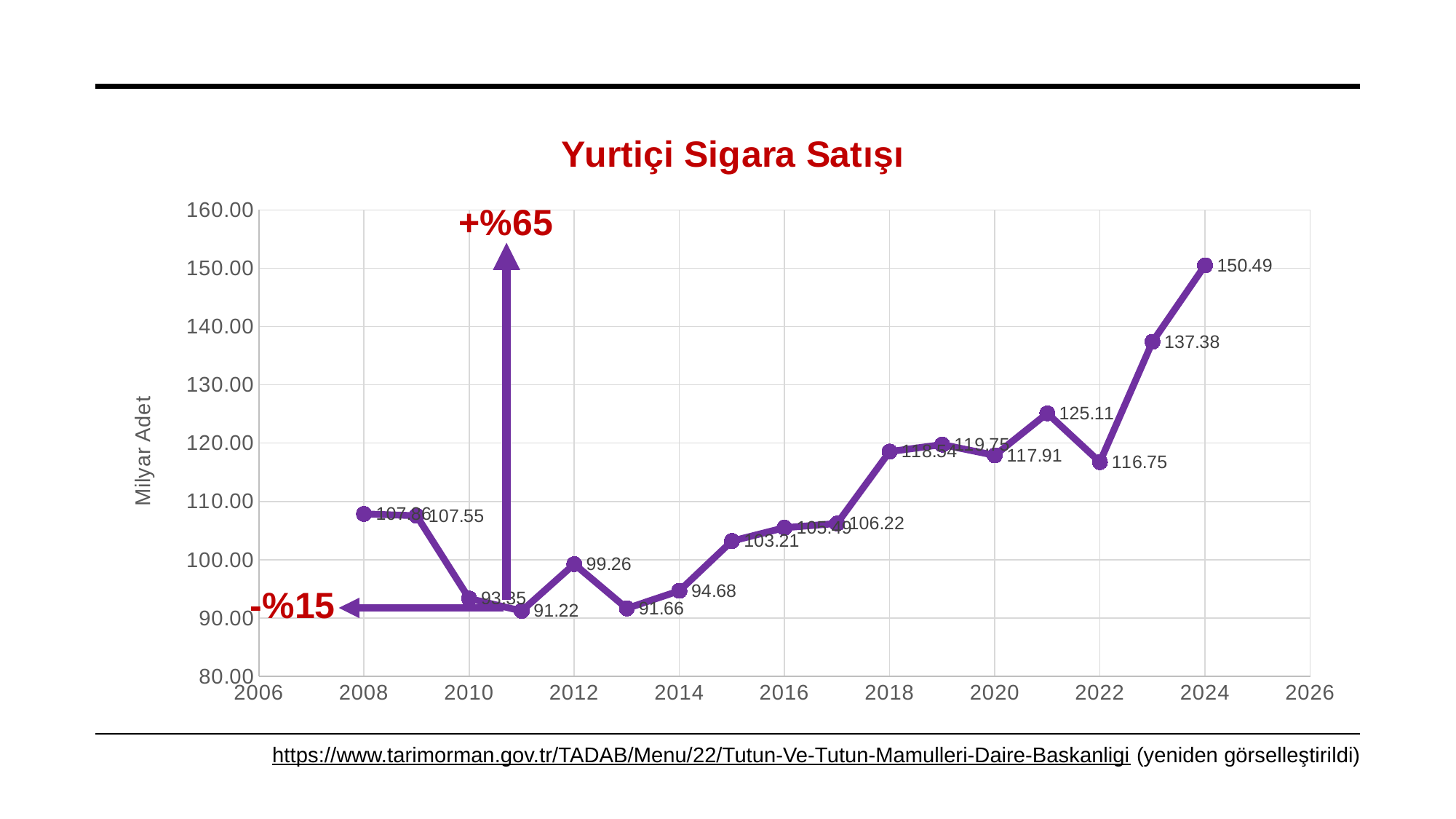
What is the value for 2021? 125.11 How many data points are plotted on the chart? 17 What is the title of the chart? Yurtiçi Sigara Satışı Which year has the lowest value? 2011 What type of chart is shown on the slide? line chart What is the label on the vertical axis of the chart? Milyar Adet What is the value for 2011? 91.22 What is the value for 2024? 150.49 What is the difference between the values for 2024 and 2023? 13.11 Which year has the highest value? 2024 What is the value for 2023? 137.38 Which is larger, the value for 2021 or the value for 2022? 2021